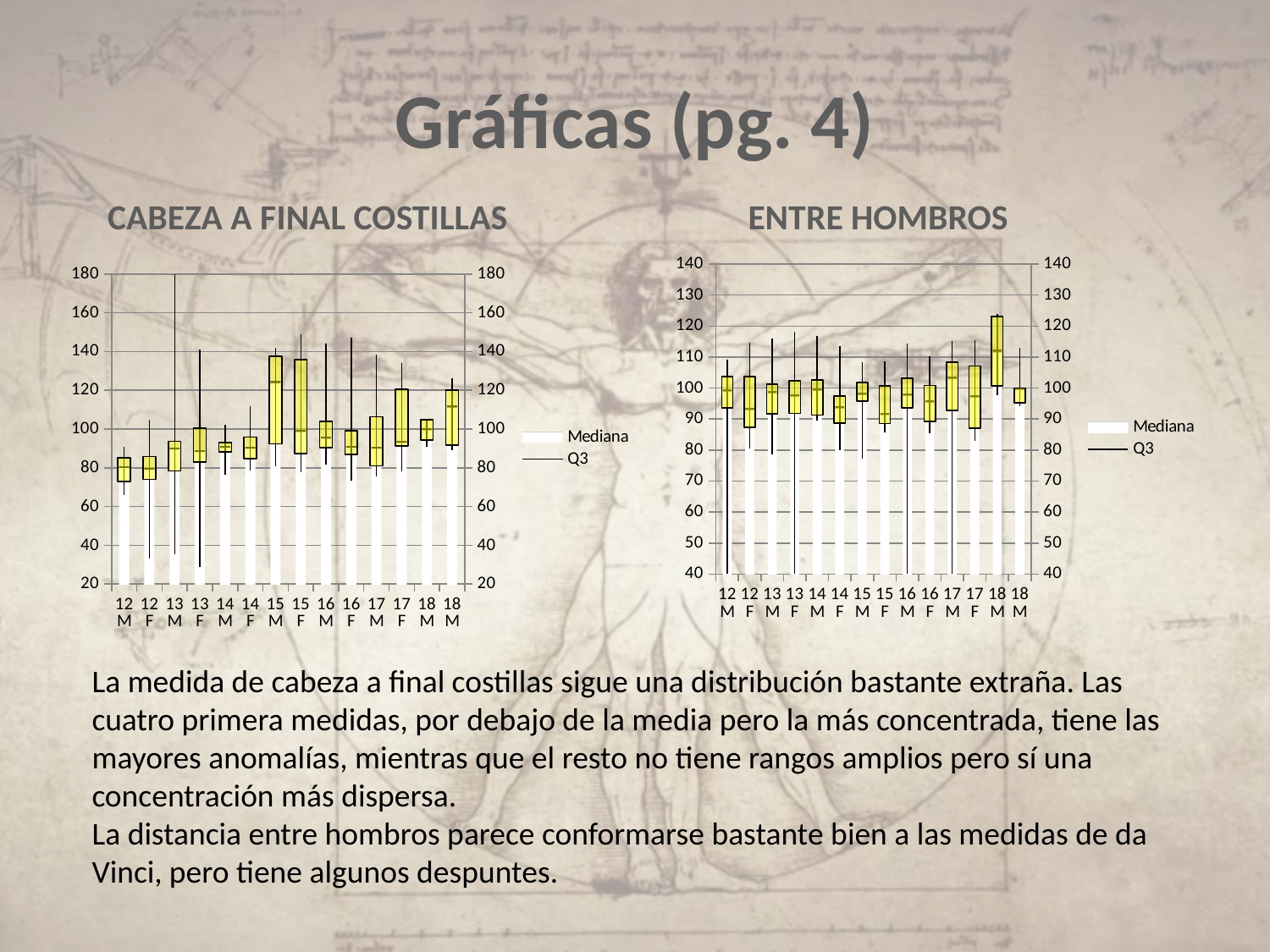
In the CABEZA A FINAL COSTILLAS chart, which has the larger median, 15 M or 12 F? 15 M How many categories are shown on the x axis of the ENTRE HOMBROS chart? 14 In the ENTRE HOMBROS chart, which category has the highest median? 18 M What is the maximum value shown on the vertical axis of the ENTRE HOMBROS chart? 140 In the CABEZA A FINAL COSTILLAS chart, is the median for 15 M greater or less than 100? greater In the ENTRE HOMBROS chart, is the median for 12 F greater or less than 100? less What kind of chart is the CABEZA A FINAL COSTILLAS chart? box plot (box-and-whisker chart) In the CABEZA A FINAL COSTILLAS chart, is the median for 12 M greater or less than 100? less How many series does the legend of the CABEZA A FINAL COSTILLAS chart list? 2 What are the two legend entries of the ENTRE HOMBROS chart? Mediana and Q3 In the CABEZA A FINAL COSTILLAS chart, which category has the highest median? 15 M